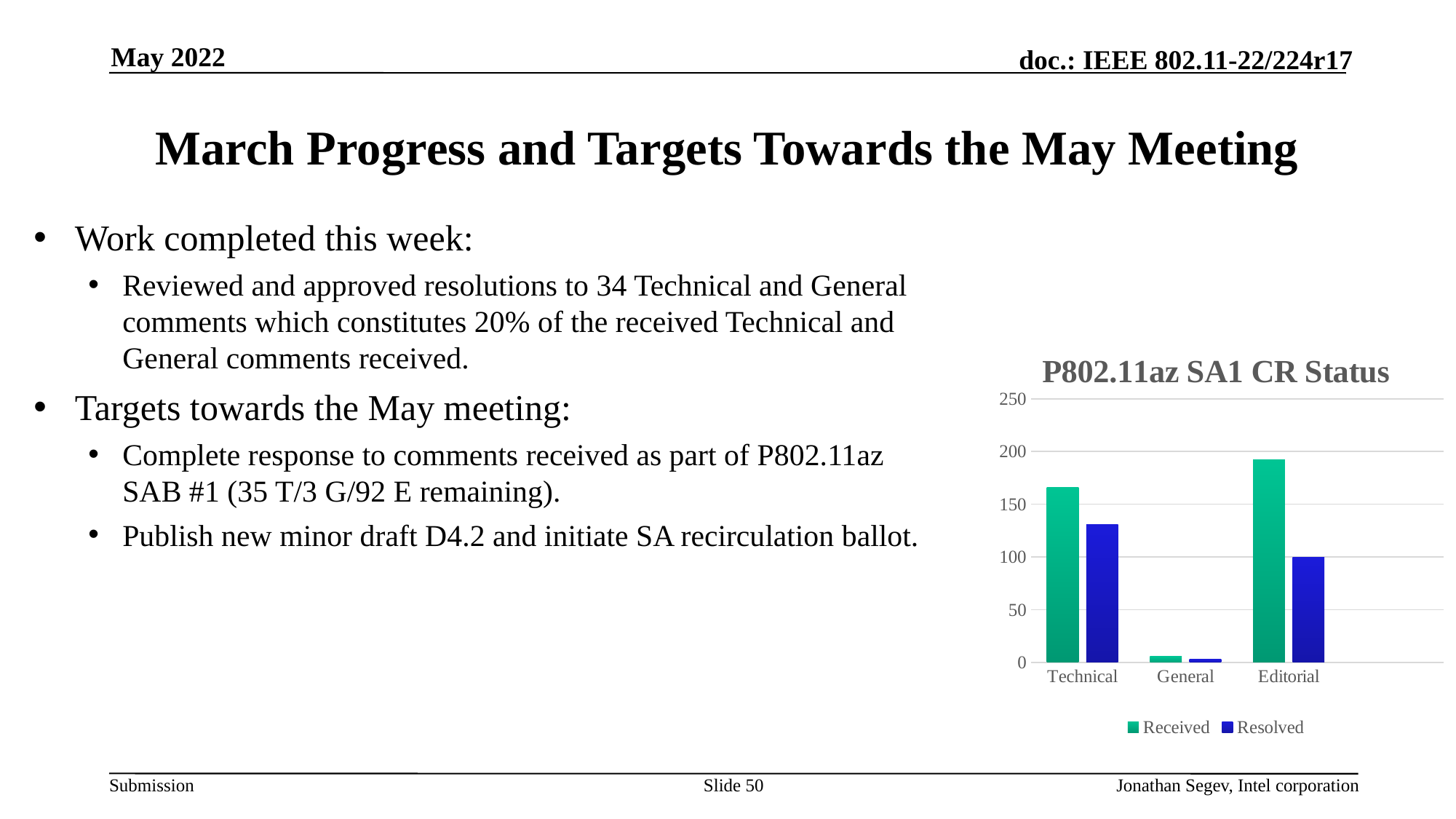
Which series are listed in the chart's legend? Received and Resolved How many categories are shown on the x axis of the chart? 3 Which category has the lowest Resolved value? General What type of chart is shown on the slide? bar chart What is the title of the chart on the slide? P802.11az SA1 CR Status Is the Resolved value for Technical greater or less than 150? less Which is larger, the Resolved value for Technical or the Resolved value for Editorial? Technical Is the Received value for General greater or less than 50? less Is the Received value for Technical greater or less than 150? greater How many series does the chart's legend list? 2 Which category has the highest Received value? Editorial